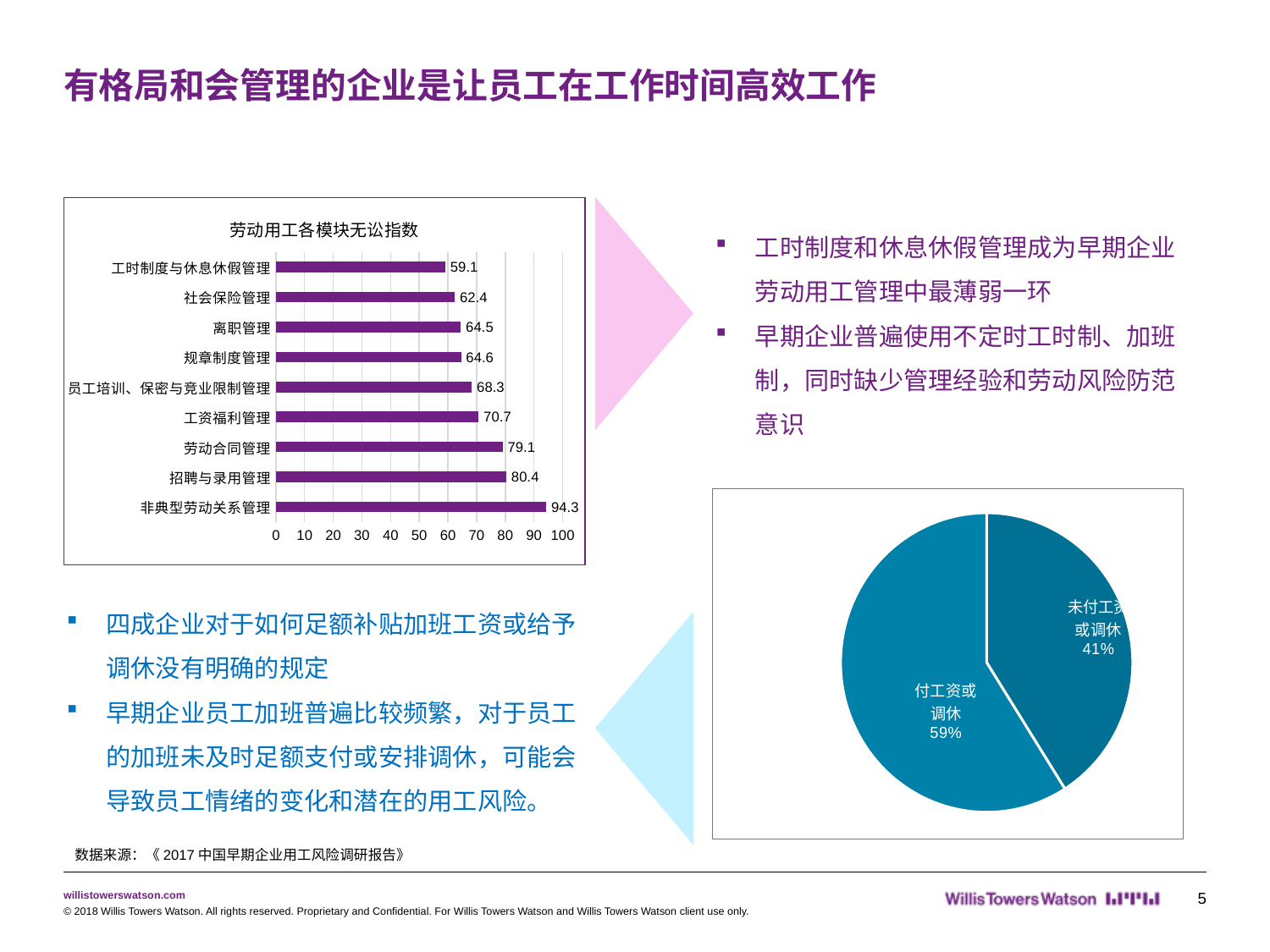
In the bar chart titled 劳动用工各模块无讼指数, what is the difference between the values for 非典型劳动关系管理 and 工时制度与休息休假管理? 35.2 In the pie chart on the right of the slide, what share does 未付工资或调休 have? 41% In the bar chart titled 劳动用工各模块无讼指数, which category has the lowest value? 工时制度与休息休假管理 In the bar chart titled 劳动用工各模块无讼指数, which category has the highest value? 非典型劳动关系管理 What kind of chart is the chart titled 劳动用工各模块无讼指数 on the left of the slide? Bar chart In the bar chart titled 劳动用工各模块无讼指数, what is the value for 劳动合同管理? 79.1 How many categories are shown in the bar chart titled 劳动用工各模块无讼指数? 9 In the bar chart titled 劳动用工各模块无讼指数, what is the value for 工时制度与休息休假管理? 59.1 How many slices does the pie chart on the right of the slide have? 2 In the bar chart titled 劳动用工各模块无讼指数, which is larger: the value for 招聘与录用管理 or the value for 工资福利管理? 招聘与录用管理 In the pie chart on the right of the slide, what share does 付工资或调休 have? 59% In the bar chart titled 劳动用工各模块无讼指数, what is the value for 非典型劳动关系管理? 94.3